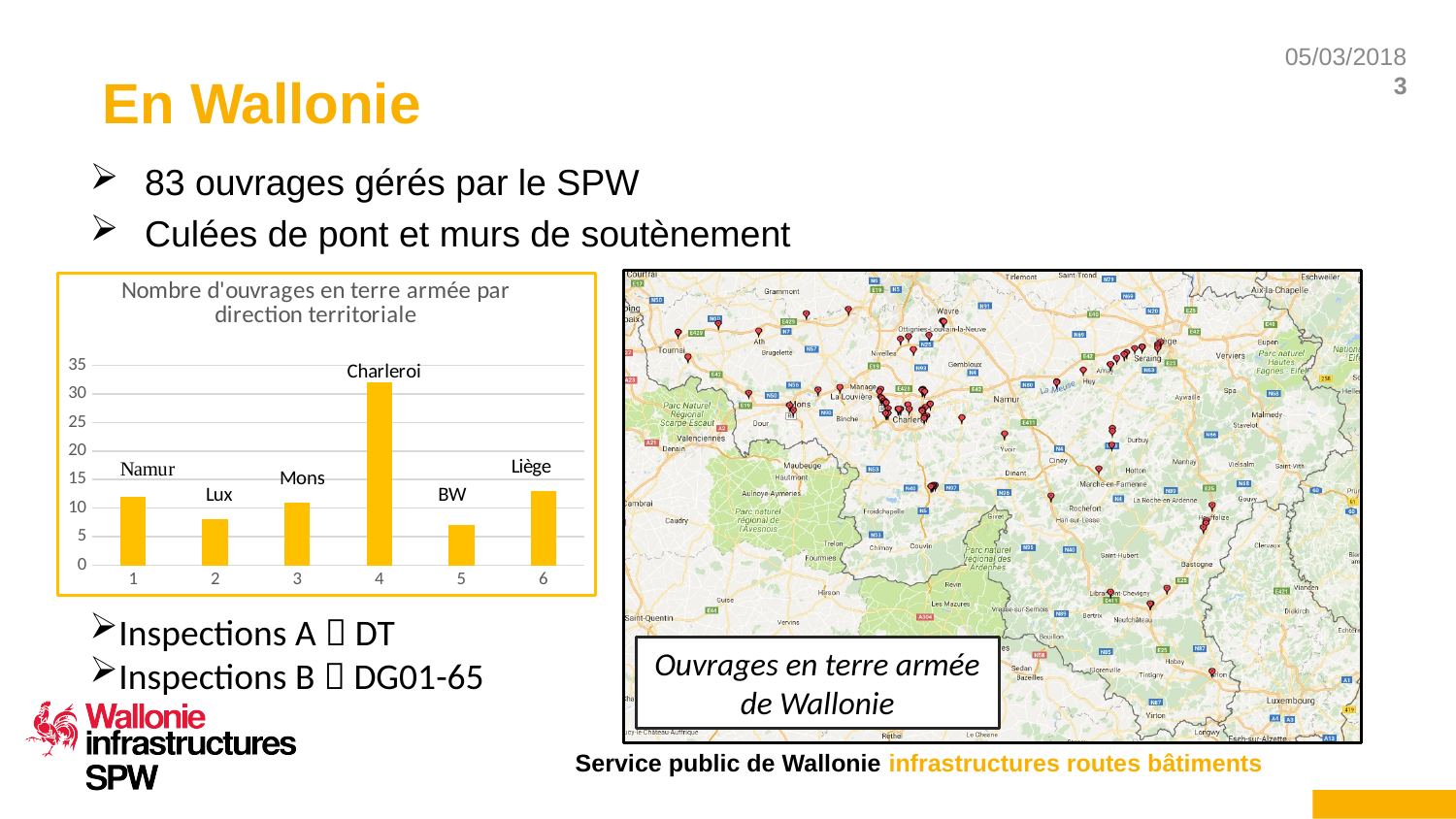
What kind of chart is shown on the slide? bar chart How many bars (directions territoriales) does the chart show? 6 Is the value for Lux greater or less than 10? less What is the title of the chart on the slide? Nombre d'ouvrages en terre armée par direction territoriale Is the value for Namur greater or less than 15? less Is the value for Liège greater or less than 15? less Which is larger, the value for Liège or the value for BW? Liège What colour are the bars in the chart? yellow Which direction territoriale has the highest number of ouvrages en terre armée? Charleroi Which is larger, the value for Charleroi or the value for Namur? Charleroi